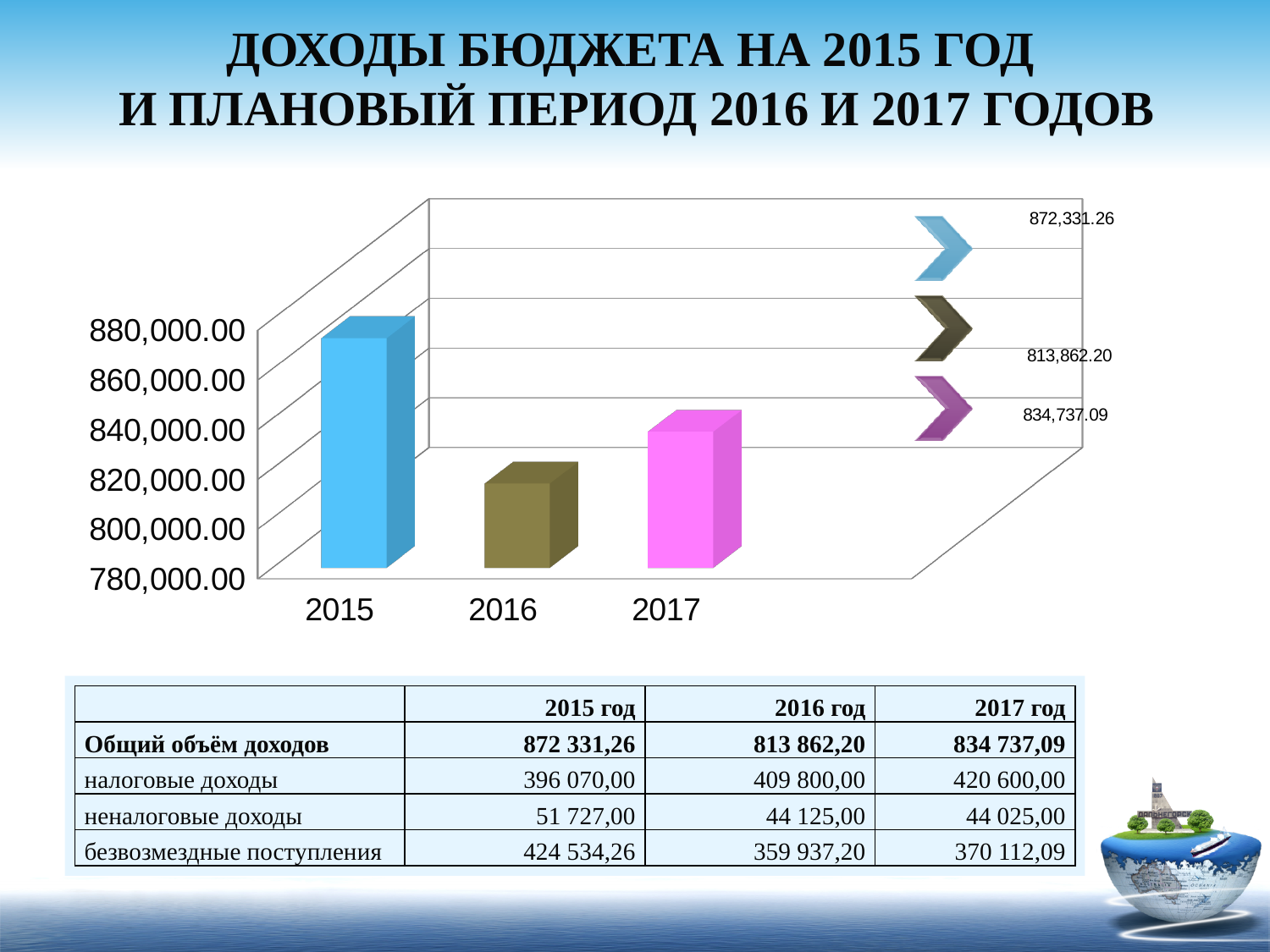
Which year has the lowest value? 2016 How many years are plotted on the chart? 3 What is the value shown for 2017? 834,737.09 What is the value shown for 2016? 813,862.20 What kind of chart is shown on the slide? bar chart What is the difference between the values for 2017 and 2016? 20,874.89 Which year has the highest value? 2015 Which is larger, the value for 2017 or the value for 2016? 2017 What is the value shown for 2015? 872,331.26 What is the difference between the values for 2015 and 2016? 58,469.06 Is the value for 2016 greater or less than 820,000.00? less What colour is the bar for 2015? blue